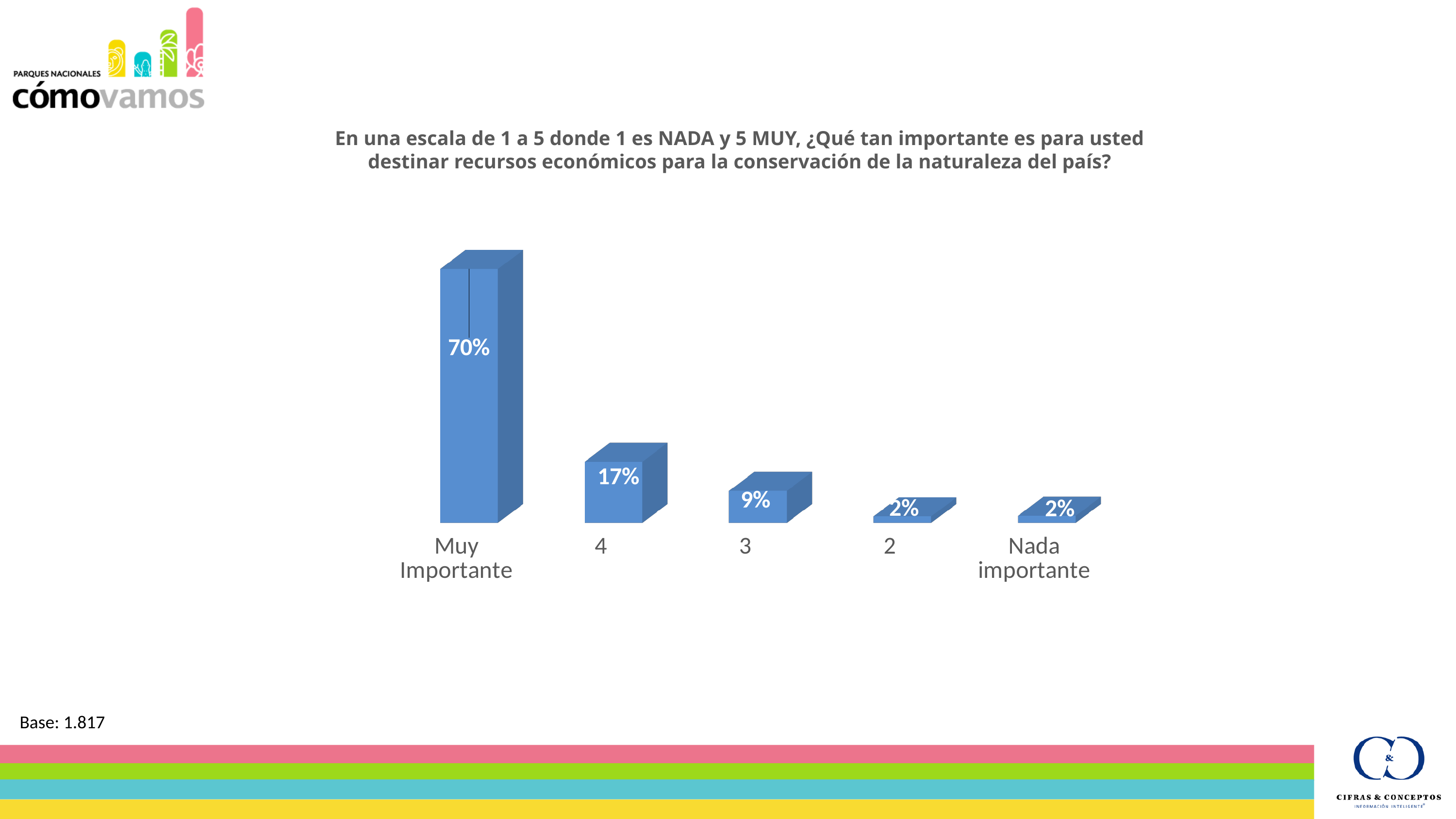
What percentage of respondents answered "Nada importante"? 2% What is the base (number of respondents) noted on the slide? 1.817 What is the difference between the values for "Muy Importante" and category 4? 53% How many categories are shown on the chart? 5 Which category has the highest value? Muy Importante What is the difference between the values for category 4 and category 3? 8% What is the value shown for category 4? 17% What kind of chart is shown on the slide? Bar chart What is the value shown for category 3? 9% Which is larger, the value for category 3 or the value for category 2? 3 Do the values rise or fall from left to right across the categories? Fall What percentage of respondents answered "Muy Importante"? 70%